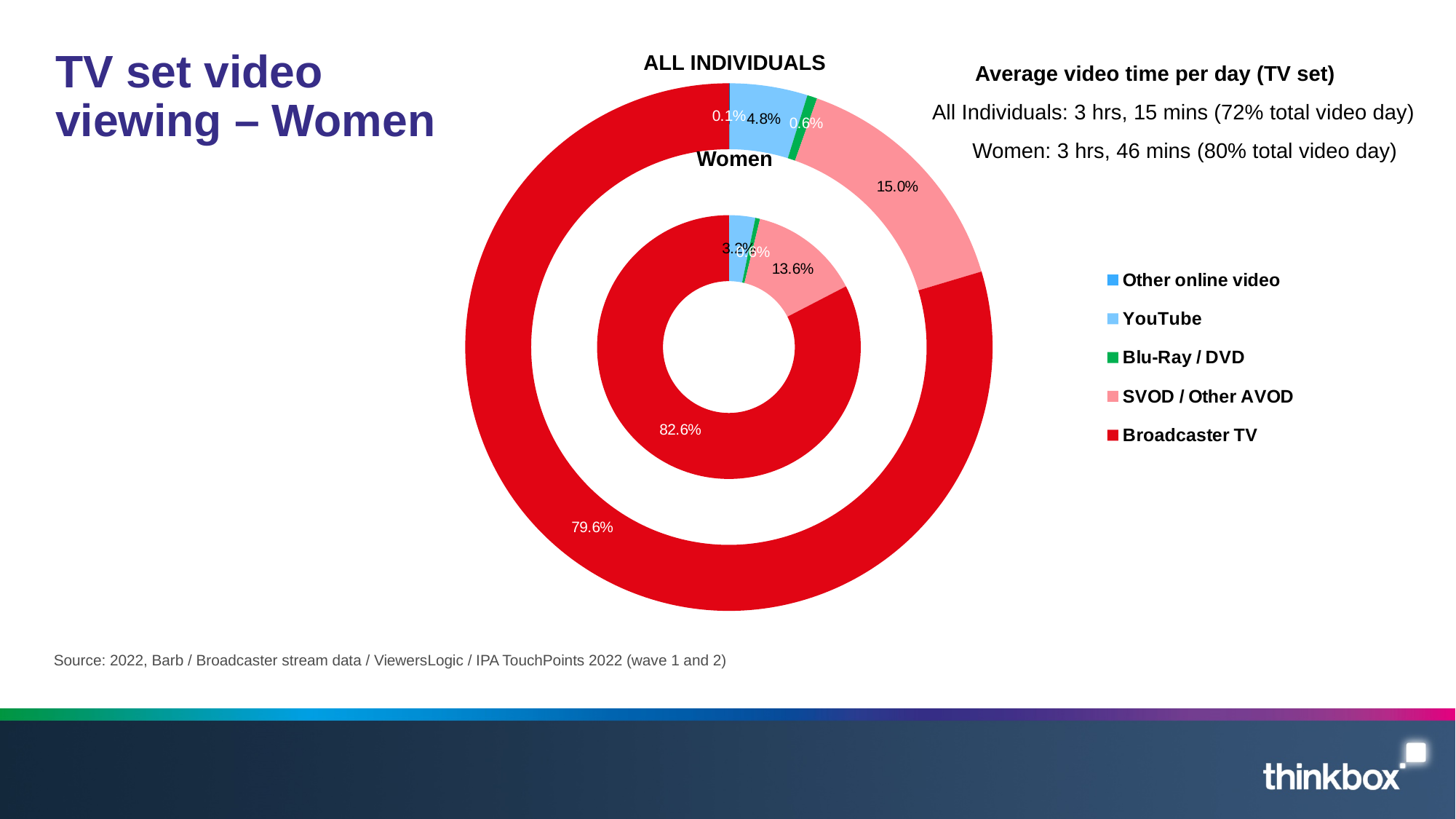
In the Women ring, what share is SVOD / Other AVOD? 13.6% In the Women ring, what share is Broadcaster TV? 82.6% How many series does the legend list? 5 In the Women ring, what share is YouTube? 3.2% In the ALL INDIVIDUALS ring, what share is YouTube? 4.8% In the ALL INDIVIDUALS ring, what share is Broadcaster TV? 79.6% In the ALL INDIVIDUALS ring, what share is Blu-Ray / DVD? 0.6% Is the Broadcaster TV share larger for Women or for ALL INDIVIDUALS? Women What is the difference between the Broadcaster TV share for Women and for ALL INDIVIDUALS? 3.0% In the ALL INDIVIDUALS ring, what share is SVOD / Other AVOD? 15.0% Which category has the largest share in the Women ring? Broadcaster TV What kind of chart is shown on the slide? Doughnut chart